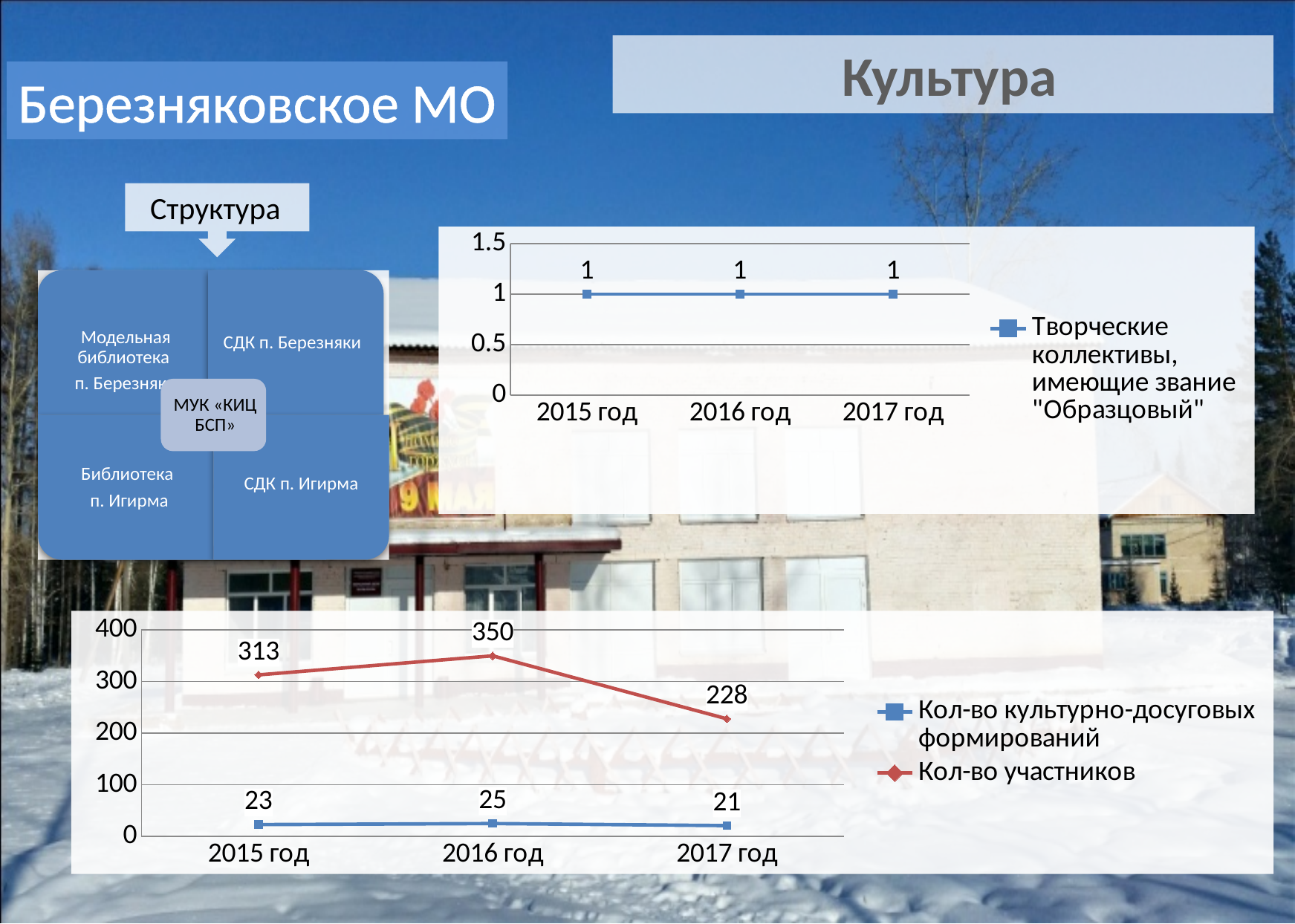
In the bottom chart, what is the value of "Кол-во участников" for 2016 год? 350 In the bottom chart, which year has the highest value for "Кол-во участников"? 2016 год In the top-right chart, do the values rise, fall or stay the same from 2015 год to 2017 год? stay the same In the bottom chart, is the value for "Кол-во участников" in 2017 год greater or less than 300? less In the bottom chart, which year has the lowest value for "Кол-во культурно-досуговых формирований"? 2017 год How many series does the legend of the bottom chart list? 2 What kind of chart is the bottom chart? line chart In the top-right chart, what is the value for 2016 год? 1 In the bottom chart, what is the difference between the "Кол-во участников" values for 2016 год and 2017 год? 122 In the bottom chart, is the "Кол-во участников" value for 2015 год or for 2017 год larger? 2015 год In the bottom chart, what is the value of "Кол-во культурно-досуговых формирований" for 2017 год? 21 How many years are shown on the x axis of the top-right chart? 3